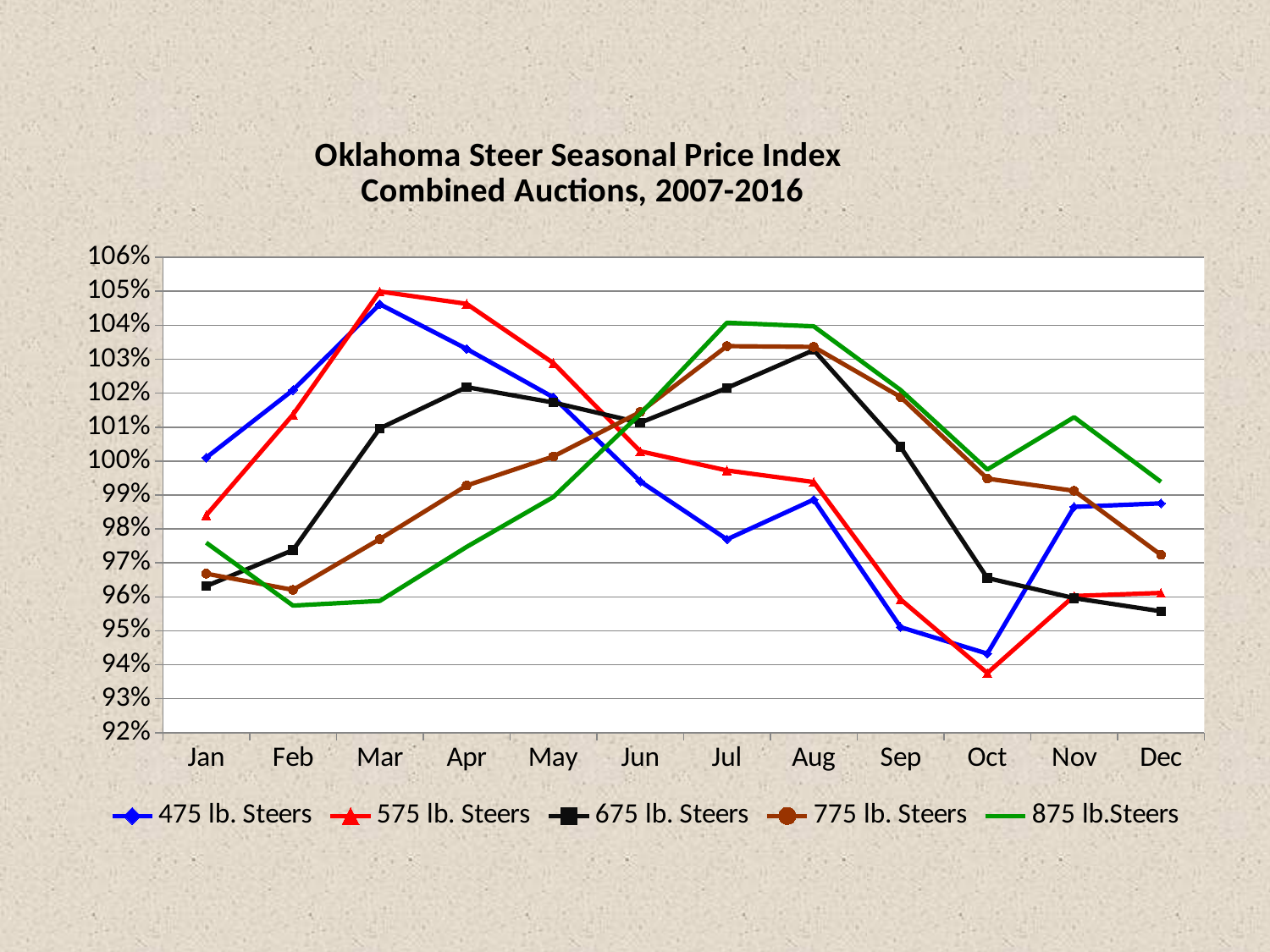
Does the 875 lb. Steers series rise or fall from Feb to Jul? Rise How many series does the legend list? 5 In which month does the 575 lb. Steers series reach its highest value? Mar How many months are plotted along the x axis? 12 In Jan, which series has the higher value: 475 lb. Steers or 575 lb. Steers? 475 lb. Steers In which month does the 575 lb. Steers series reach its lowest value? Oct Is the value for 875 lb. Steers in Jul greater or less than 103%? greater What kind of chart is shown on the slide? Line chart In which month does the 675 lb. Steers series reach its highest value? Aug Is the value for 575 lb. Steers in Oct greater or less than 95%? less What is the title of the chart? Oklahoma Steer Seasonal Price Index Combined Auctions, 2007-2016 In which month does the 475 lb. Steers series reach its lowest value? Oct